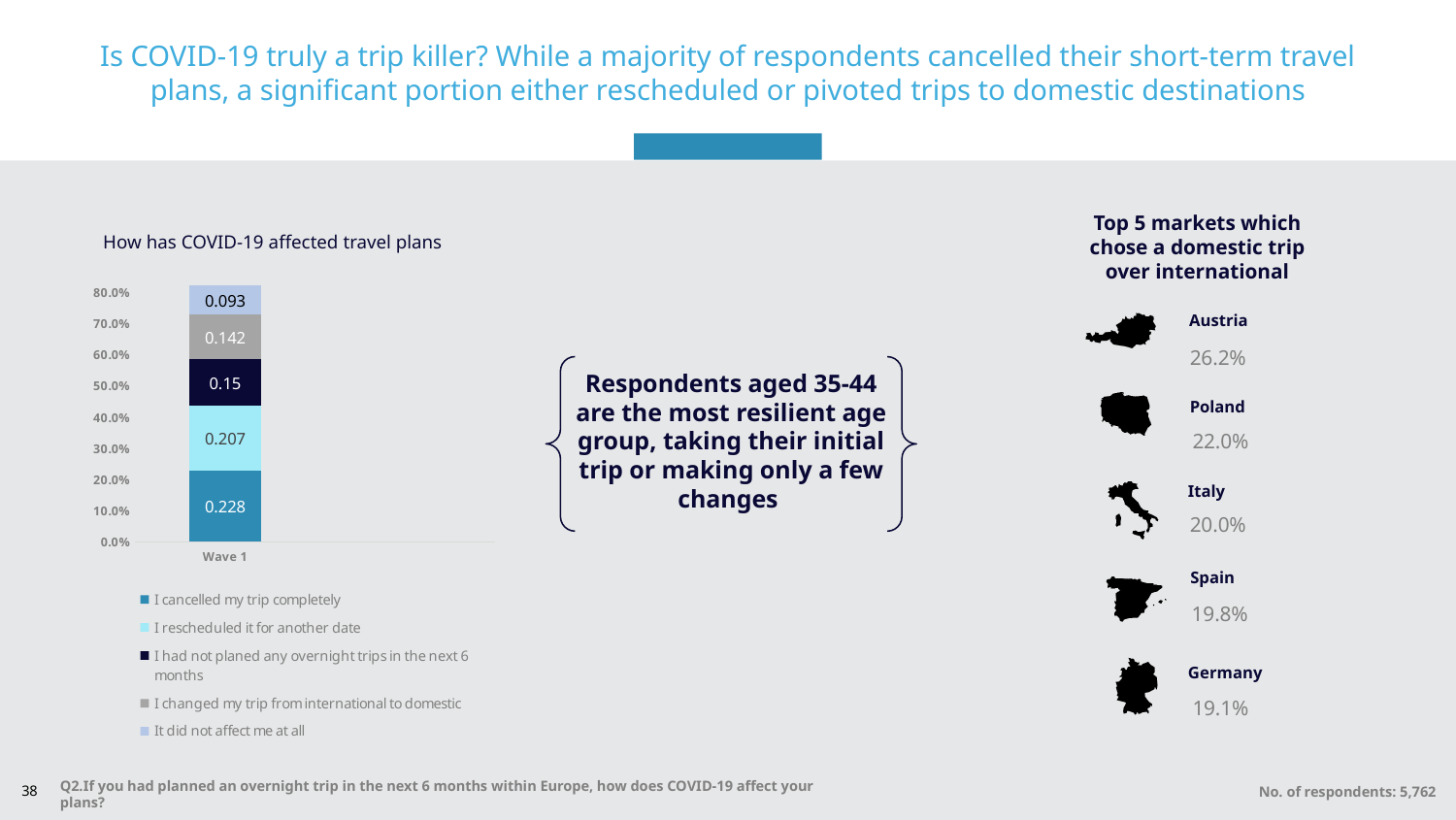
In the chart 'How has COVID-19 affected travel plans', which response has the smallest value? It did not affect me at all In the chart 'How has COVID-19 affected travel plans', what is the value for 'I changed my trip from international to domestic'? 0.142 In the chart 'How has COVID-19 affected travel plans', what is the value for 'It did not affect me at all'? 0.093 In the chart 'How has COVID-19 affected travel plans', what is the value for 'I cancelled my trip completely'? 0.228 How many series does the legend of the chart 'How has COVID-19 affected travel plans' list? 5 In the chart 'How has COVID-19 affected travel plans', what is the total of the stacked bar for Wave 1? 0.82 What kind of chart is 'How has COVID-19 affected travel plans'? Stacked bar chart How many categories are shown on the x axis of the chart 'How has COVID-19 affected travel plans'? 1 In the chart 'How has COVID-19 affected travel plans', which is larger: 'I had not planed any overnight trips in the next 6 months' or 'I changed my trip from international to domestic'? I had not planed any overnight trips in the next 6 months In the chart 'How has COVID-19 affected travel plans', what is the difference between 'I cancelled my trip completely' and 'I rescheduled it for another date'? 0.021 In the chart 'How has COVID-19 affected travel plans', which response has the largest value? I cancelled my trip completely In the chart 'How has COVID-19 affected travel plans', what is the value for 'I rescheduled it for another date'? 0.207